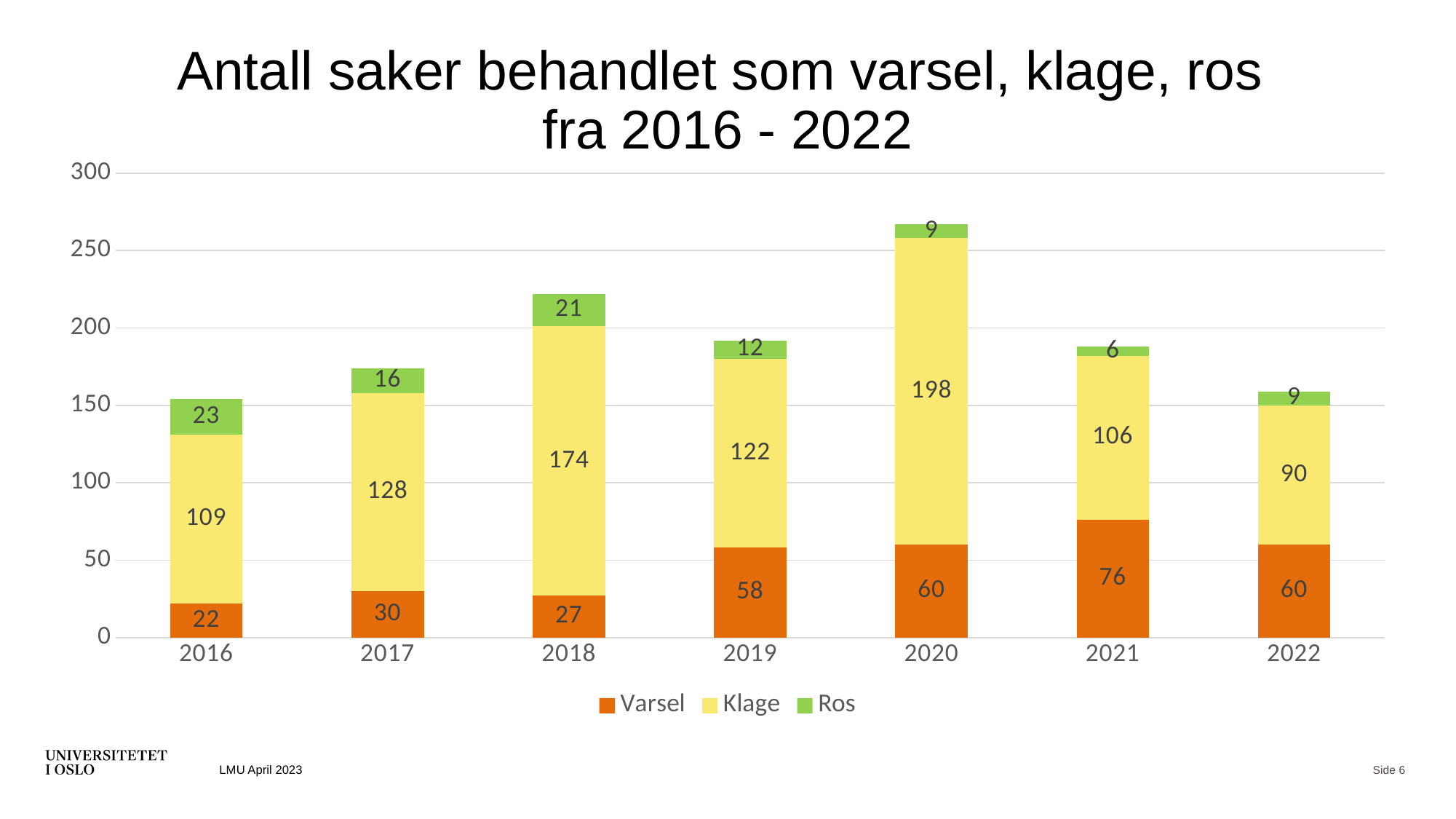
What is the Klage value for 2018? 174 What is the difference between the Klage values for 2020 and 2022? 108 What is the total of the stacked bar for 2020? 267 How many years are shown on the x axis? 7 What is the Ros value for 2016? 23 Which is larger, the Varsel value for 2019 or the Varsel value for 2017? 2019 Which year has the highest Klage value? 2020 How many series does the legend list? 3 Which year has the lowest Ros value? 2021 What is the Varsel value for 2021? 76 What kind of chart is shown on the slide? Stacked bar chart What is the total of the stacked bar for 2016? 154